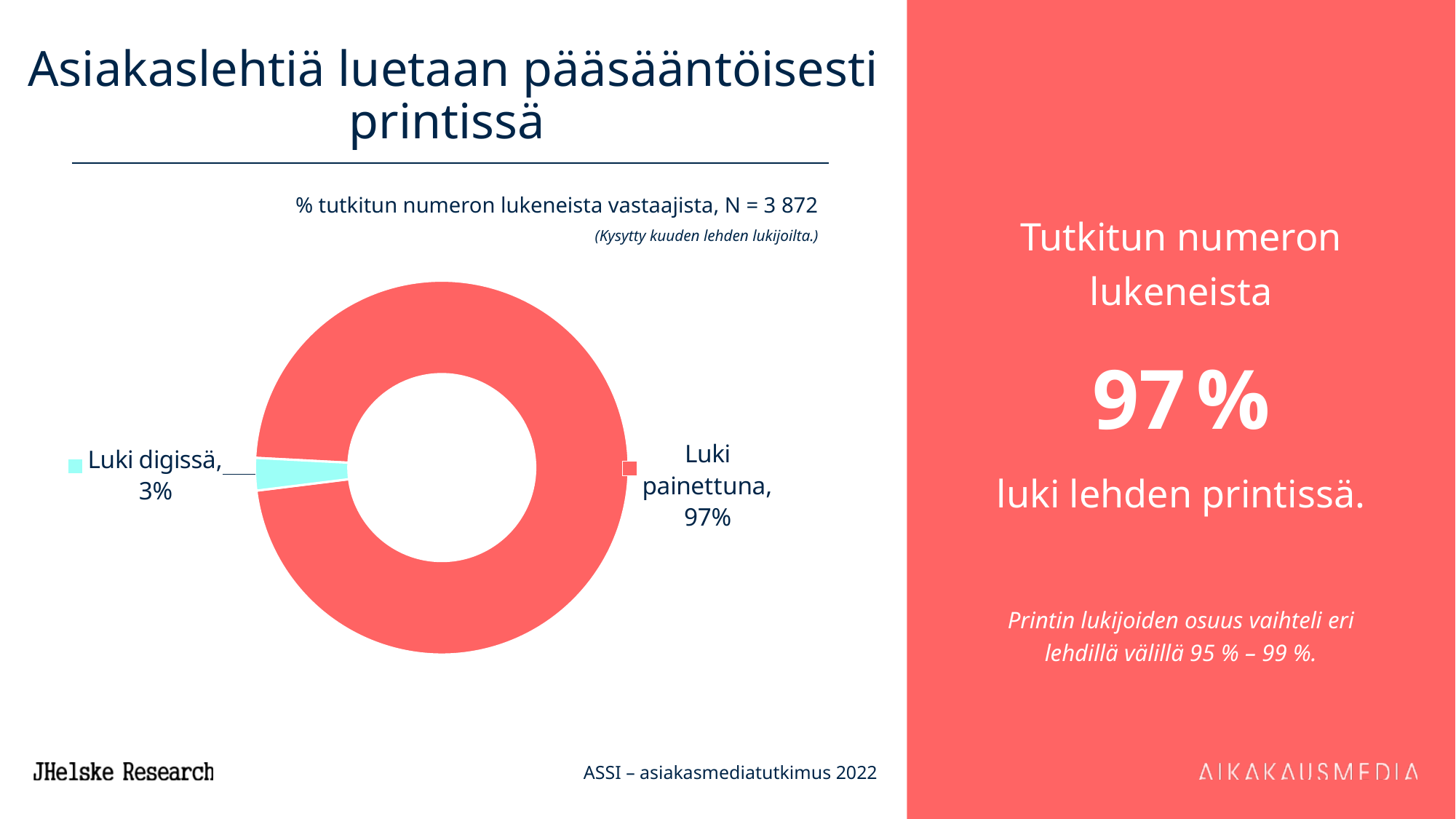
How many categories are shown in the chart? 2 What percentage of respondents read the issue digitally (Luki digissä)? 3% Which is larger, the share for Luki digissä or the share for Luki painettuna? Luki painettuna What share of the pie does the Luki digissä slice represent? 3% What colour is the Luki painettuna slice of the chart? Red Which category has the smallest share of the chart? Luki digissä What percentage of respondents read the issue in print (Luki painettuna)? 97% Which category has the largest share of the chart? Luki painettuna What is the difference in percentage points between Luki painettuna and Luki digissä? 94 What kind of chart is shown on the slide? Pie chart (doughnut) What is the sample size (N) stated above the chart? 3 872